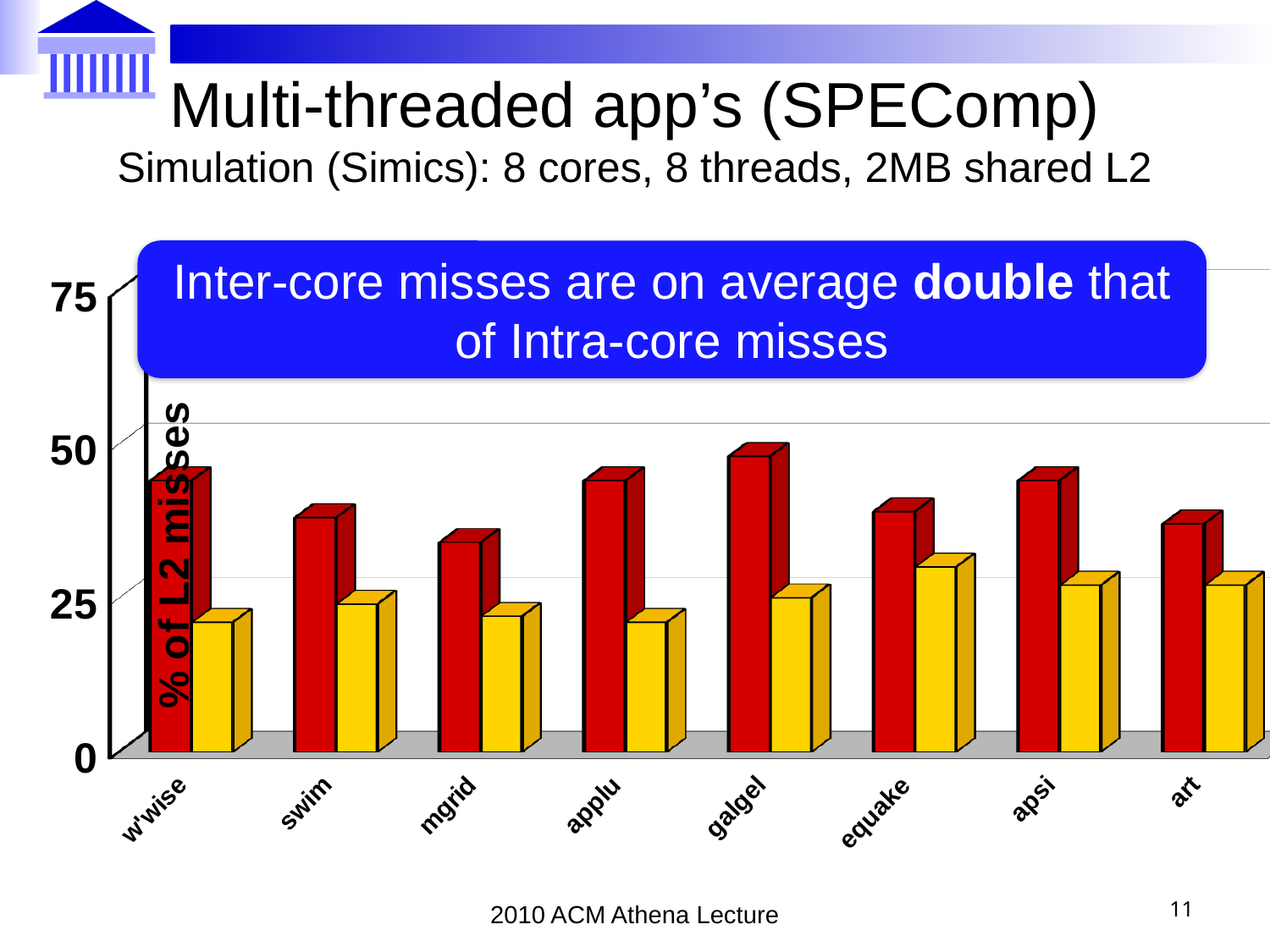
How many application categories are shown along the x axis? 8 Which application has the tallest red bar? galgel Which application has the shortest red bar? mgrid What is the label on the vertical axis of the chart? % of L2 misses Is the red bar for mgrid greater or less than 25? greater How many bars are plotted for each application category? 2 For galgel, which bar is taller, the red bar or the yellow bar? red What kind of chart is shown on the slide? bar chart Is the yellow bar for equake greater or less than 25? greater Is the red bar for w'wise greater or less than 50? less Which application has the tallest yellow bar? equake